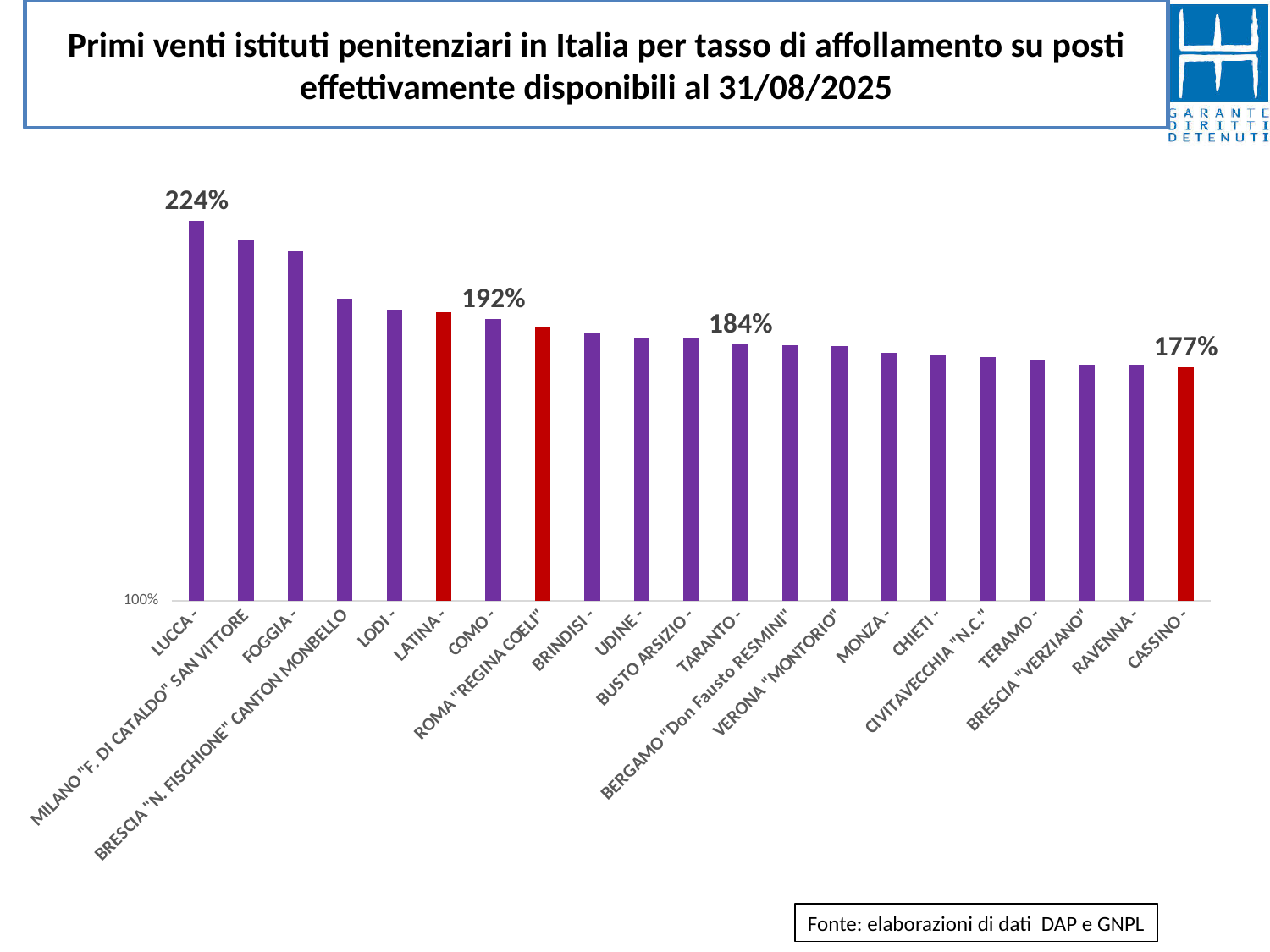
Which institute has the lowest overcrowding rate among those shown? CASSINO Do the values rise or fall from left to right along the x axis? fall What is the value for LUCCA? 224% Which institute has the highest overcrowding rate? LUCCA What kind of chart is shown on the slide? bar chart What is the value for CASSINO? 177% What is the value for TARANTO? 184% Which is larger, the value for LATINA or the value for TARANTO? LATINA How many institutes are shown in the chart? 21 What is the difference between the values for LUCCA and CASSINO? 47% Is the value for FOGGIA greater or less than 100%? greater